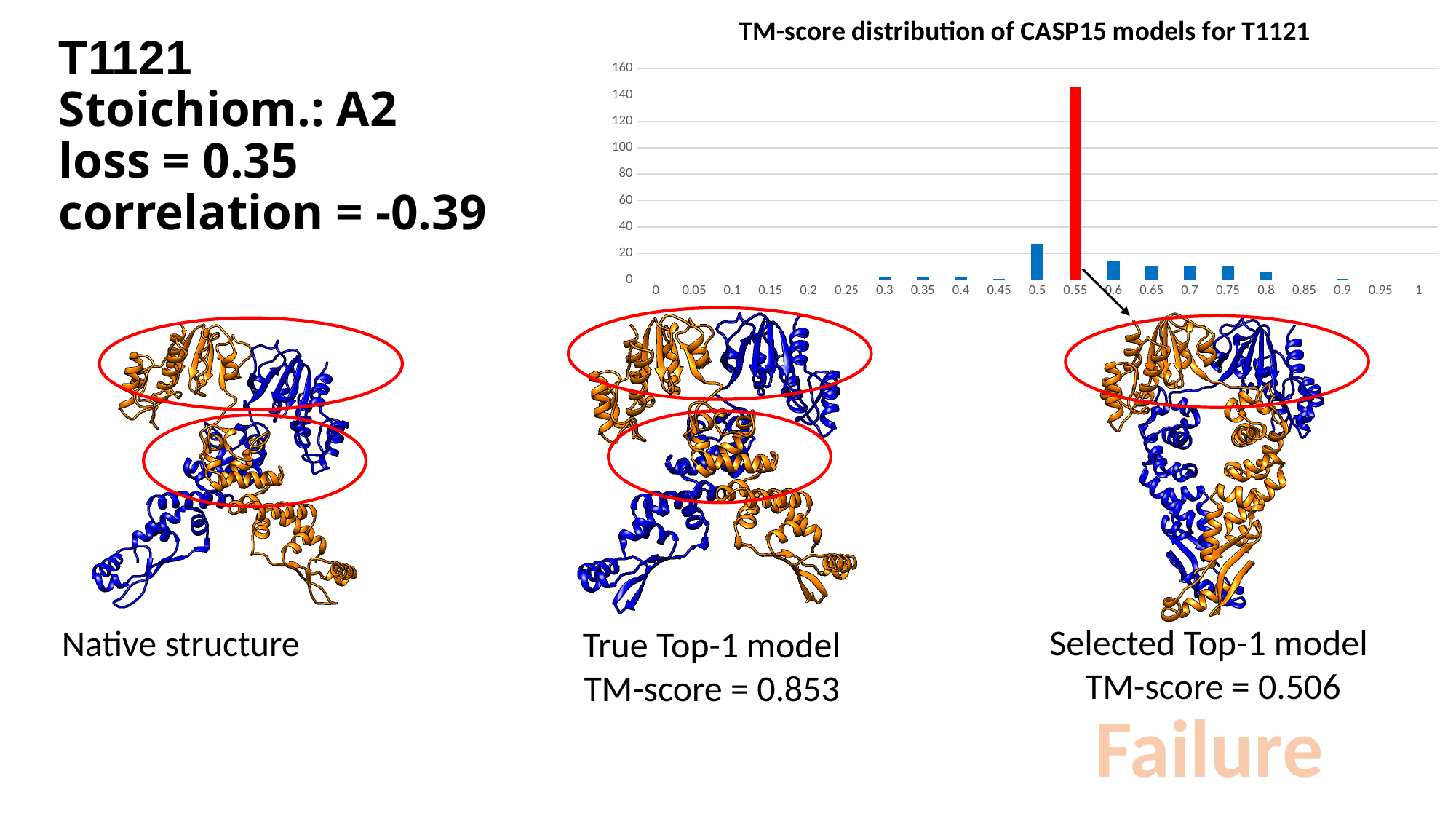
How many TM-score bins are labelled on the x axis of the chart? 21 Is the value for the 0.5 bin greater or less than 40? less Is the value for the 0.6 bin greater or less than 20? less What is the highest tick value shown on the y axis of the chart? 160 What is the title of the chart? TM-score distribution of CASP15 models for T1121 Is the value for the 0.55 bin greater or less than 120? greater Which bin has a larger value, 0.55 or 0.5? 0.55 Which bin has a larger value, 0.5 or 0.6? 0.5 What kind of chart is shown on the slide? bar chart Which TM-score bin has the highest bar in the chart? 0.55 What colour is the tallest bar in the chart? red